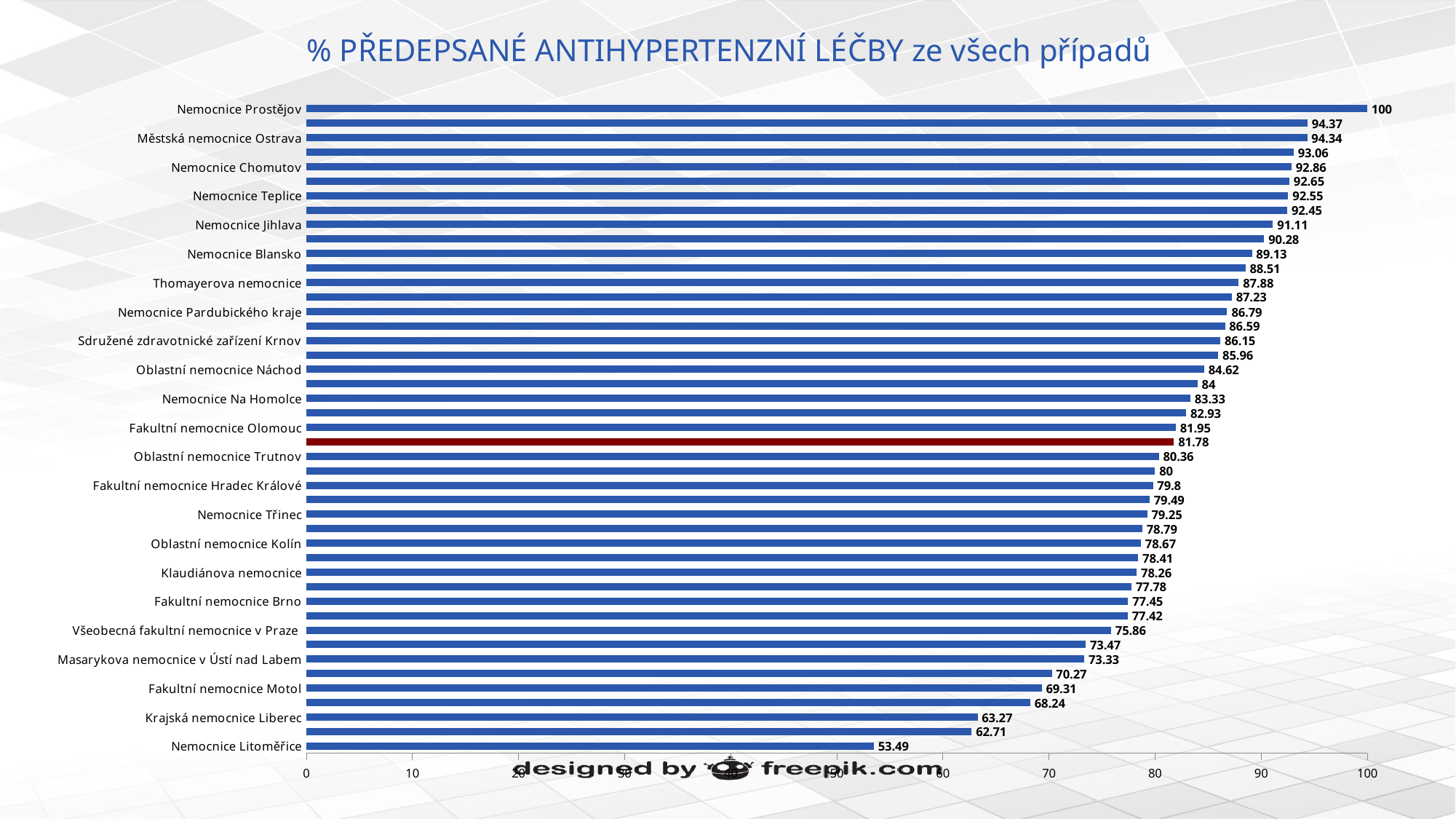
Is the value for Masarykova nemocnice v Ústí nad Labem greater or less than 80? less What is the title of the chart? % PŘEDEPSANÉ ANTIHYPERTENZNÍ LÉČBY ze všech případů Which hospital has the lowest value? Nemocnice Litoměřice What is the value for Fakultní nemocnice Motol? 69.31 What is the value for Nemocnice Prostějov? 100 What is the value for Krajská nemocnice Liberec? 63.27 What is the value of the bar highlighted in dark red? 81.78 What is the difference between the values for Nemocnice Prostějov and Nemocnice Litoměřice? 46.51 What kind of chart is shown on the slide? bar chart What is the value for Nemocnice Na Homolce? 83.33 Which hospital has the highest value? Nemocnice Prostějov Which is larger, the value for Nemocnice Jihlava or the value for Fakultní nemocnice Brno? Nemocnice Jihlava